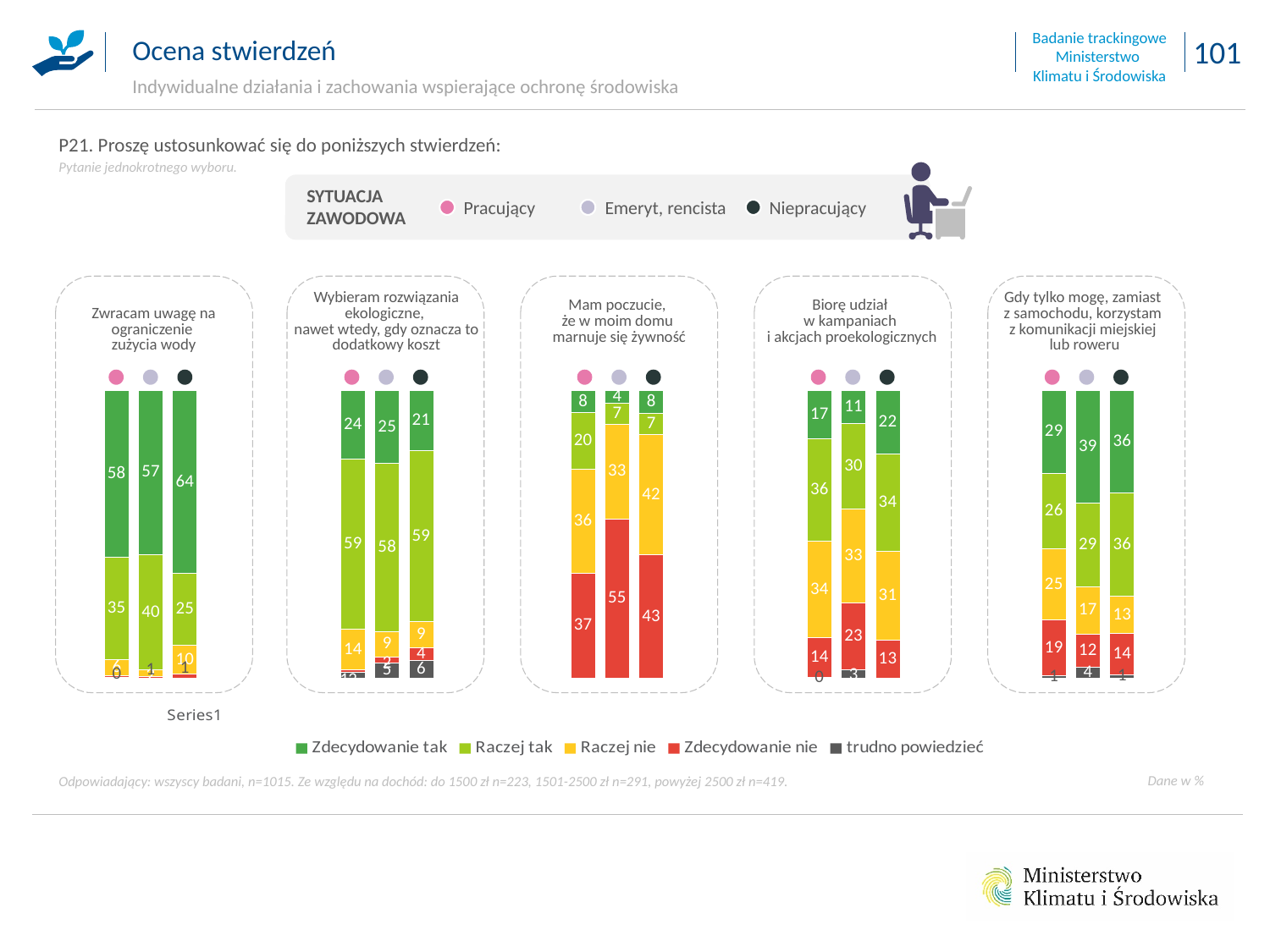
How many series does the legend at the bottom of the slide list? 5 In the chart 'Zwracam uwagę na ograniczenie zużycia wody', which group has the highest 'Zdecydowanie tak' value? Niepracujący In the chart 'Biorę udział w kampaniach i akcjach proekologicznych', what is the 'Zdecydowanie nie' value for Emeryt, rencista? 23 In the chart 'Wybieram rozwiązania ekologiczne, nawet wtedy, gdy oznacza to dodatkowy koszt', what is the 'Raczej tak' value for Emeryt, rencista? 58 In the chart 'Mam poczucie, że w moim domu marnuje się żywność', what is the difference between the 'Raczej nie' values for Niepracujący and Pracujący? 6 In the chart 'Biorę udział w kampaniach i akcjach proekologicznych', which is larger: the 'Zdecydowanie tak' value for Pracujący or for Niepracujący? Niepracujący In the chart 'Gdy tylko mogę, zamiast z samochodu, korzystam z komunikacji miejskiej lub roweru', what is the 'Zdecydowanie tak' value for Emeryt, rencista? 39 In the chart 'Mam poczucie, że w moim domu marnuje się żywność', what is the 'Zdecydowanie nie' value for Emeryt, rencista? 55 What kind of chart is used for each statement on the slide? Stacked bar chart In the chart 'Zwracam uwagę na ograniczenie zużycia wody', what is the 'Zdecydowanie tak' value for Niepracujący? 64 In the chart 'Gdy tylko mogę, zamiast z samochodu, korzystam z komunikacji miejskiej lub roweru', what is the difference between the 'Zdecydowanie nie' values for Pracujący and Emeryt, rencista? 7 In the chart 'Mam poczucie, że w moim domu marnuje się żywność', which group has the lowest 'Zdecydowanie nie' value? Pracujący